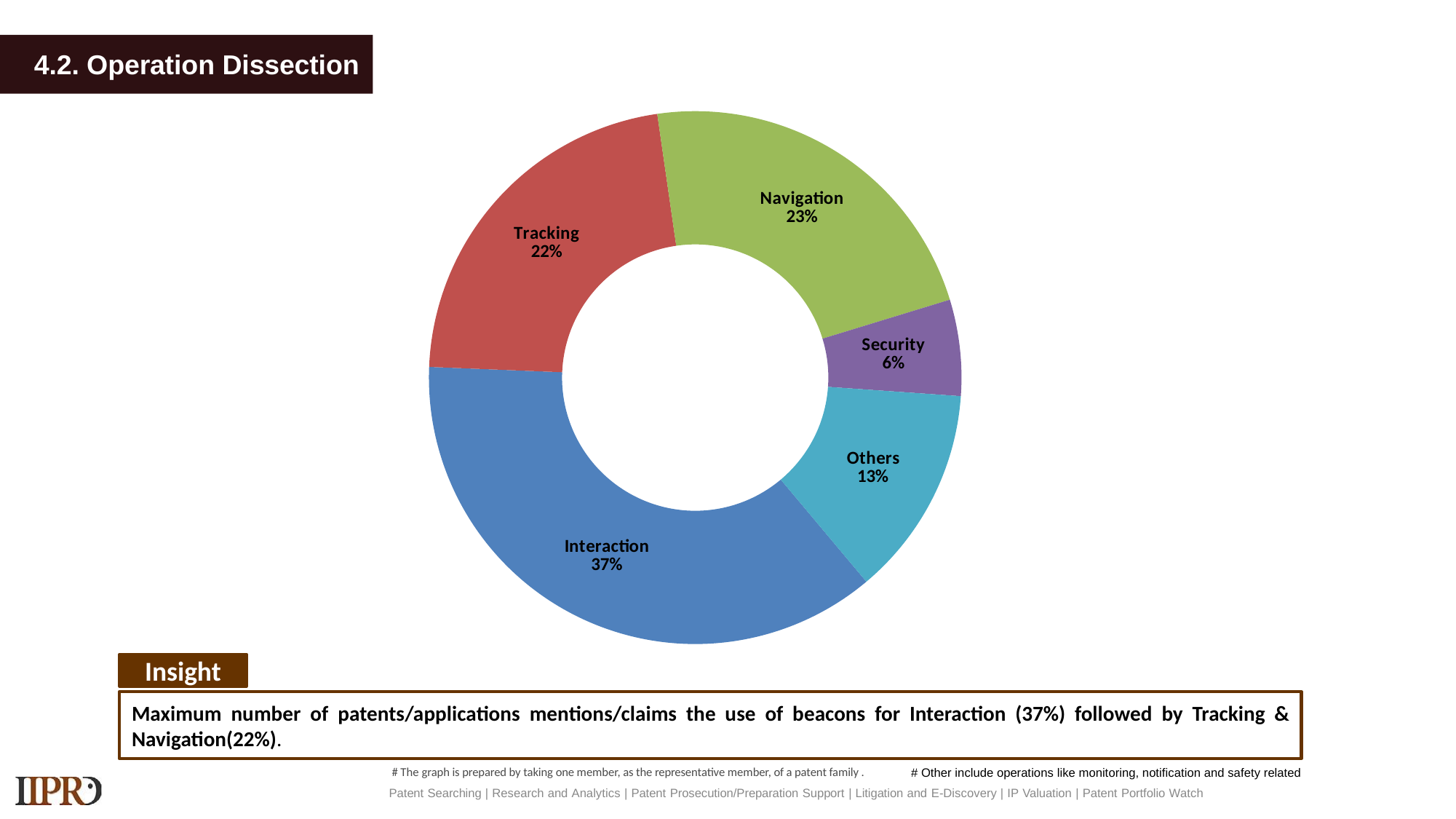
What percentage is shown for Navigation? 23% What percentage is shown for Security? 6% Which is larger, the share for Navigation or the share for Others? Navigation What share of the donut chart does Interaction account for? 37% What kind of chart is shown on the slide? Donut (pie) chart Which category has the smallest share of the chart? Security What is the difference in percentage points between Others and Security? 7 What colour is the Interaction segment? Blue Which category has the largest share of the chart? Interaction What is the difference in percentage points between Interaction and Tracking? 15 How many categories are shown in the chart? 5 What is the title of the slide containing the chart? 4.2. Operation Dissection